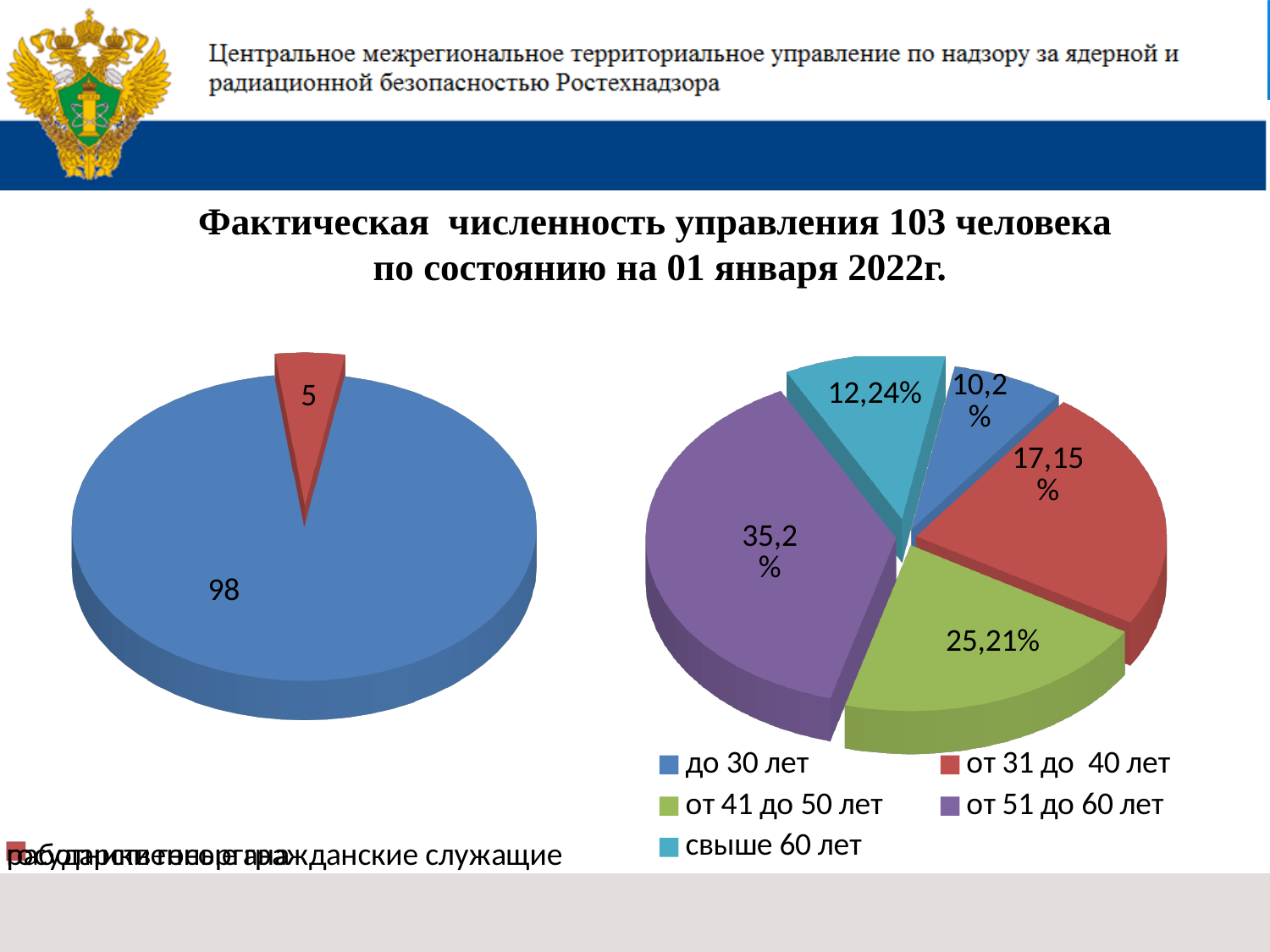
In the right pie chart, which is larger: the share for 'свыше 60 лет' or for 'до 30 лет'? свыше 60 лет In the right pie chart, which age category has the smallest share? до 30 лет In the left pie chart, what value is shown on the small red slice? 5 In the left pie chart, what value is shown on the large blue slice? 98 In the right pie chart, which age category has the largest share? от 51 до 60 лет In the right pie chart, what is the difference between the shares for 'от 41 до 50 лет' and 'от 31 до 40 лет'? 8,06% In the right pie chart, what share is shown for the category 'свыше 60 лет'? 12,24% In the right pie chart, what share is shown for the category 'до 30 лет'? 10,2% How many slices does the left pie chart have? 2 How many categories does the legend of the right pie chart list? 5 What kind of chart is the chart on the left of the slide? pie chart In the right pie chart, what share is shown for the category 'от 51 до 60 лет'? 35,2%